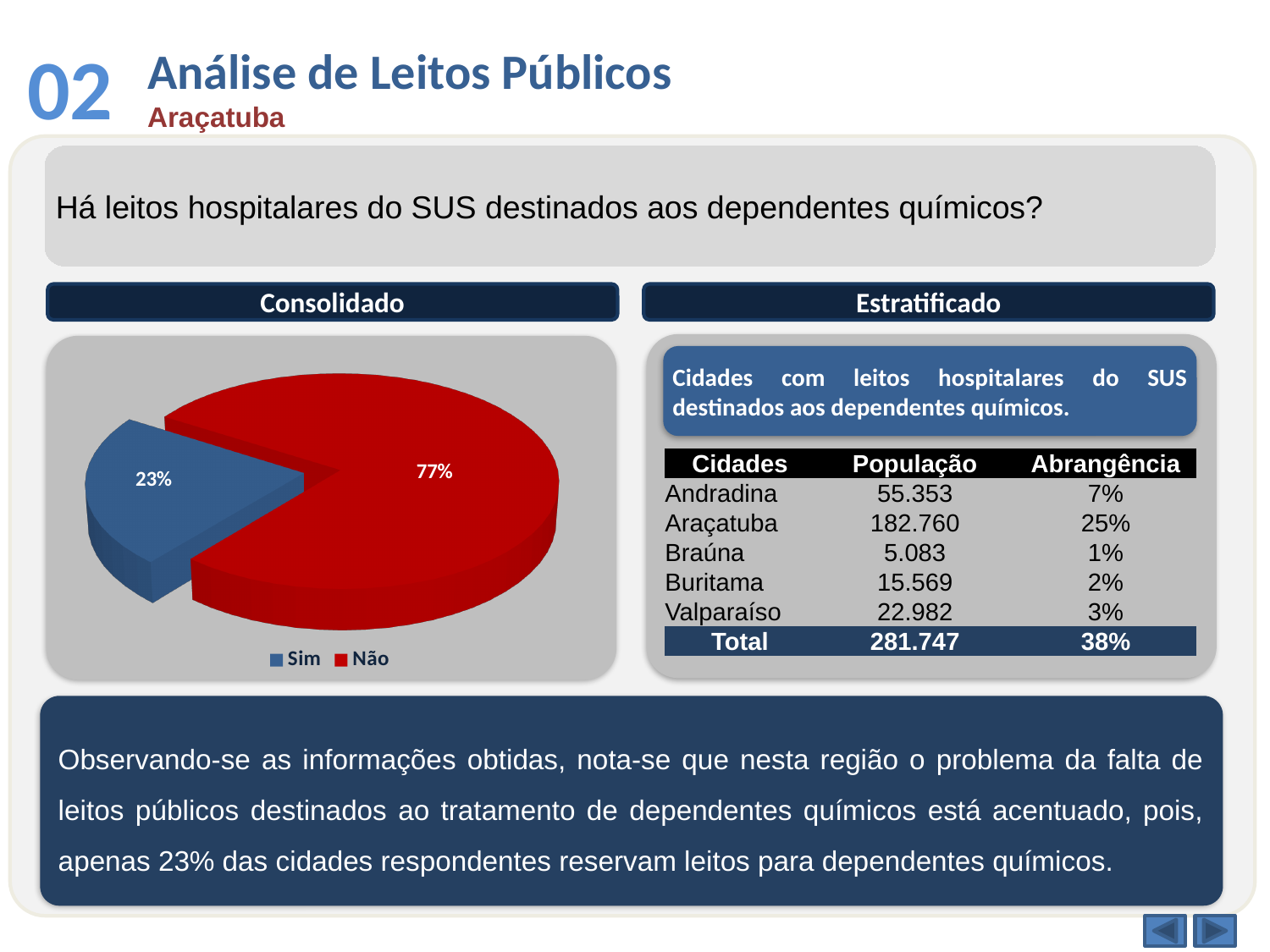
What is the difference in percentage points between the "Não" and "Sim" slices of the pie chart? 54 percentage points In the pie chart, what percentage is shown for "Sim"? 23% How many slices does the pie chart have? 2 In the pie chart, what percentage is shown for "Não"? 77% In the pie chart, which is larger: the "Sim" slice or the "Não" slice? Não What kind of chart is shown under the "Consolidado" heading? Pie chart Which slice of the pie chart is the smallest? Sim What colour is the "Não" slice in the pie chart? Red What share of the pie does the "Sim" slice represent? 23% What colour is the "Sim" slice in the pie chart? Blue Which slice of the pie chart is the largest? Não How many entries does the pie chart's legend list? 2